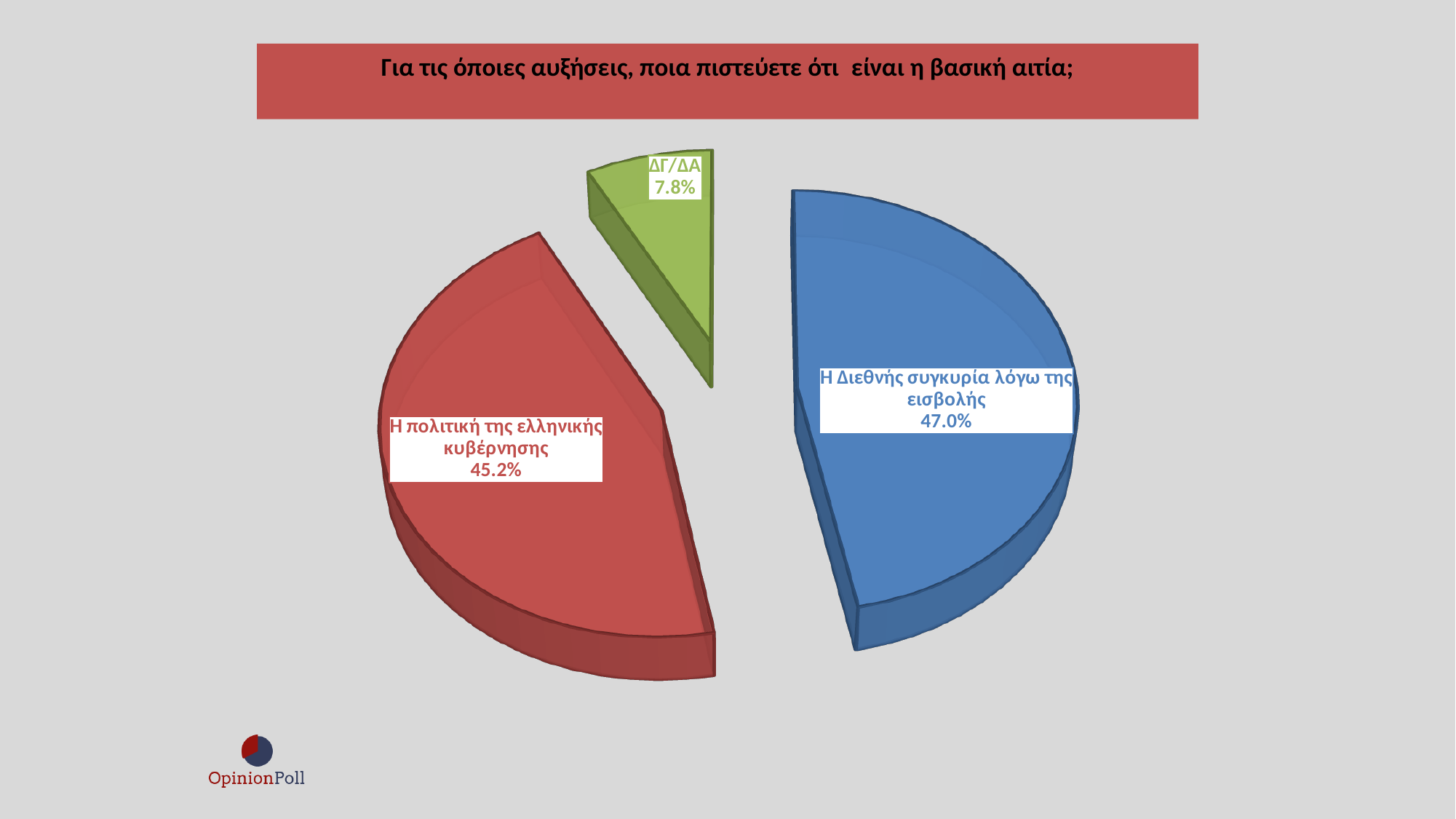
What is the difference in percentage points between "Η Διεθνής συγκυρία λόγω της εισβολής" and "Η πολιτική της ελληνικής κυβέρνησης"? 1.8 What is the title of the chart? Για τις όποιες αυξήσεις, ποια πιστεύετε ότι είναι η βασική αιτία; Which category has the smallest share of the pie? ΔΓ/ΔΑ What percentage is shown for "ΔΓ/ΔΑ"? 7.8% What is the difference in percentage points between "Η πολιτική της ελληνικής κυβέρνησης" and "ΔΓ/ΔΑ"? 37.4 What percentage is shown for "Η Διεθνής συγκυρία λόγω της εισβολής"? 47.0% What colour is the slice for "ΔΓ/ΔΑ"? Green Which category has the largest share of the pie? Η Διεθνής συγκυρία λόγω της εισβολής What kind of chart is shown on the slide? Pie chart What percentage is shown for "Η πολιτική της ελληνικής κυβέρνησης"? 45.2% How many slices does the pie chart have? 3 Which is larger: the share for "Η πολιτική της ελληνικής κυβέρνησης" or the share for "ΔΓ/ΔΑ"? Η πολιτική της ελληνικής κυβέρνησης